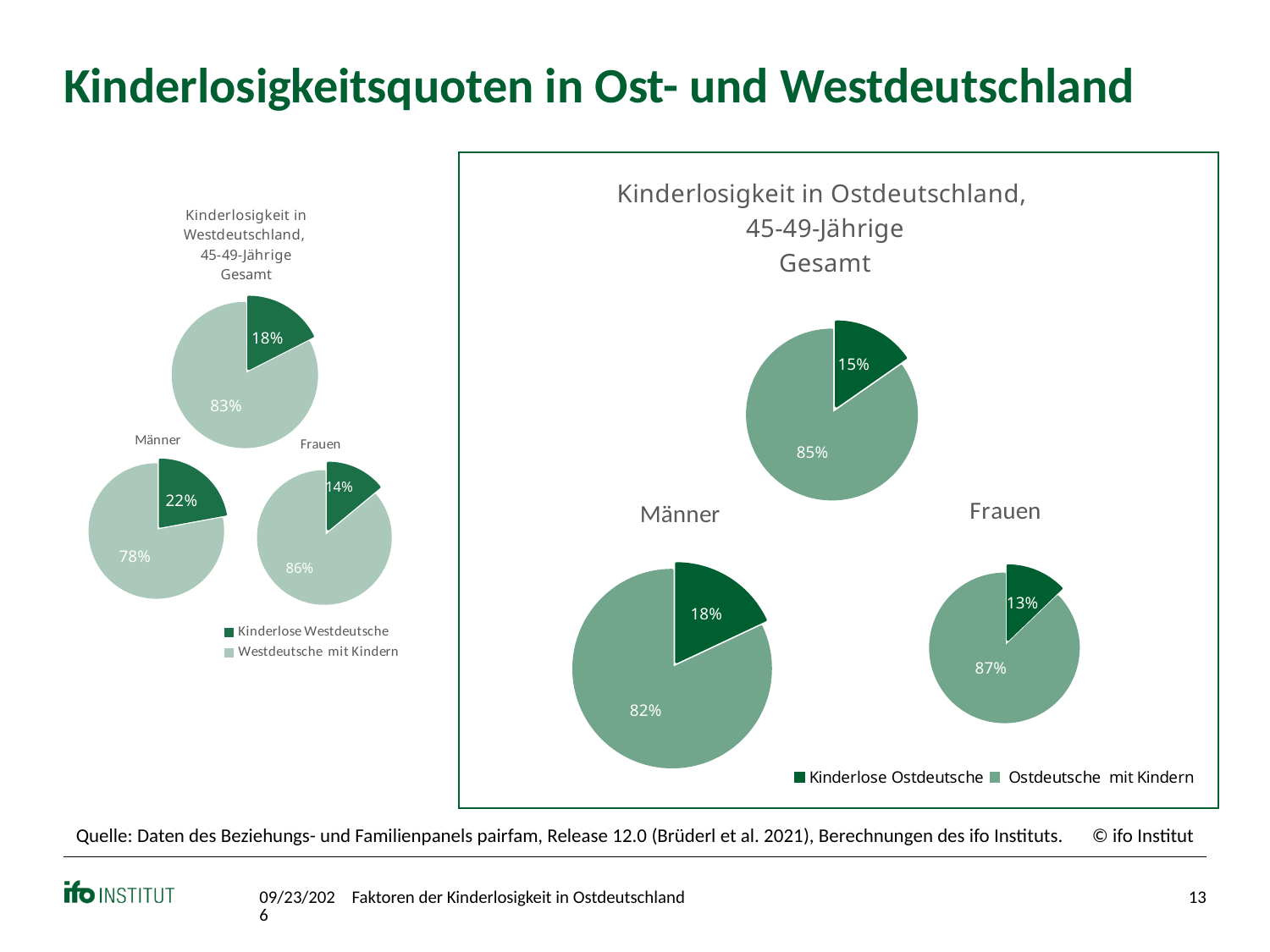
What is the difference between the childless share for Männer in Westdeutschland (22%) and for Frauen in Westdeutschland (14%)? 8 percentage points In the pie chart 'Kinderlosigkeit in Westdeutschland, 45-49-Jährige Gesamt', what share is shown for Kinderlose Westdeutsche? 18% In the 'Männer' pie chart on the right (Ostdeutschland), what share is shown for Ostdeutsche mit Kindern? 82% How many pie charts are shown on the slide in total? 6 In the pie chart 'Kinderlosigkeit in Ostdeutschland, 45-49-Jährige Gesamt', what share is shown for Kinderlose Ostdeutsche? 15% What kind of charts are shown on the slide? Pie charts In the 'Frauen' pie chart on the left (Westdeutschland), what share is shown for Kinderlose Westdeutsche? 14% In the 'Männer' pie chart on the left (Westdeutschland), what share is shown for Kinderlose Westdeutsche? 22% How many entries does the legend of the Ostdeutschland charts list? 2 In the 'Frauen' pie chart on the right (Ostdeutschland), what share is shown for Ostdeutsche mit Kindern? 87% What is the difference between the childless share for Männer in Ostdeutschland (18%) and for Frauen in Ostdeutschland (13%)? 5 percentage points Which is larger: the childless share for Männer in Westdeutschland or the childless share for Männer in Ostdeutschland? Männer in Westdeutschland